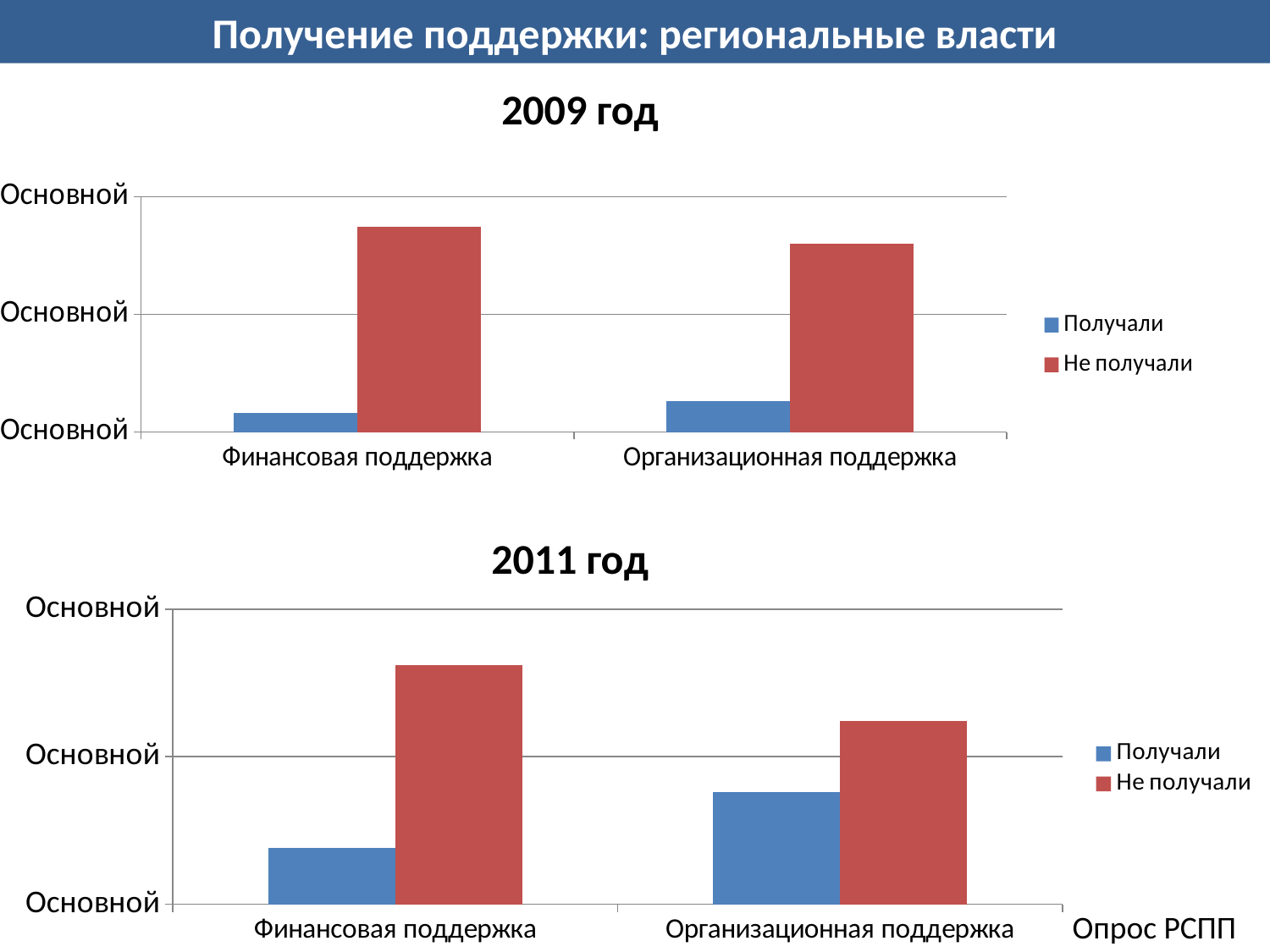
In the chart titled "2009 год", for "Финансовая поддержка", which is larger: "Получали" or "Не получали"? Не получали What is the title of the top chart on the slide? 2009 год In the chart titled "2011 год", which category has the highest value for "Получали"? Организационная поддержка In the chart titled "2011 год", for "Организационная поддержка", which is larger: "Получали" or "Не получали"? Не получали In the chart titled "2009 год", how many series does the legend list? 2 In the chart titled "2011 год", what kind of chart is shown? bar chart In the chart titled "2011 год", how many categories are shown on the x axis? 2 In the chart titled "2009 год", which category has the lowest value for "Получали"? Финансовая поддержка In the chart titled "2011 год", what are the legend entries? Получали, Не получали In the chart titled "2011 год", which category has the highest value for "Не получали"? Финансовая поддержка In the chart titled "2009 год", which category has the higher value for "Получали"? Организационная поддержка In the chart titled "2009 год", what kind of chart is shown? bar chart